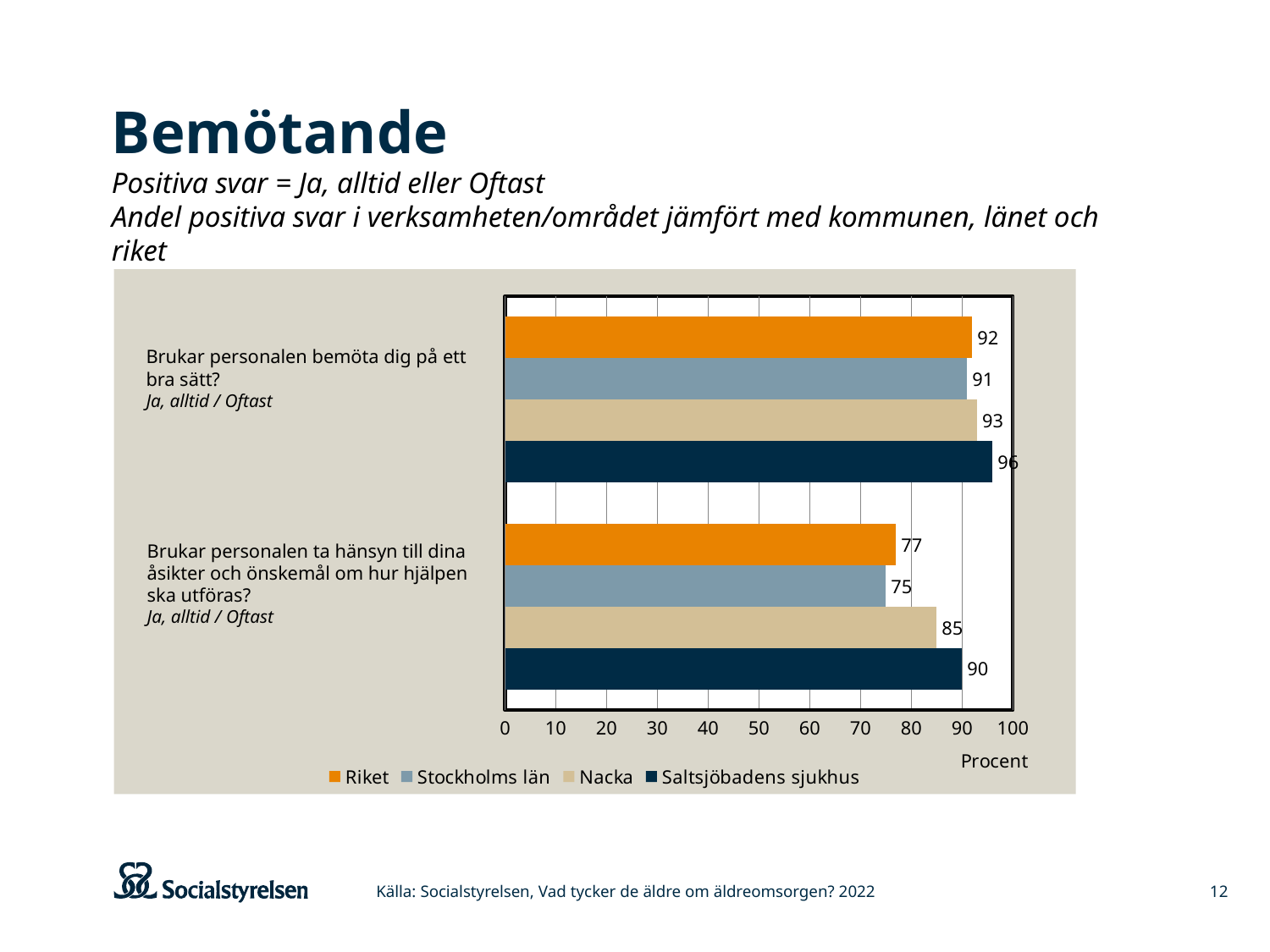
Which series has the lowest value for the question 'Brukar personalen ta hänsyn till dina åsikter och önskemål om hur hjälpen ska utföras?'? Stockholms län What is the value for Stockholms län for the question 'Brukar personalen bemöta dig på ett bra sätt?'? 91 How many question categories are shown on the chart? 2 How many series does the legend list? 4 Which is larger for Nacka: the value for 'Brukar personalen bemöta dig på ett bra sätt?' or for 'Brukar personalen ta hänsyn till dina åsikter och önskemål om hur hjälpen ska utföras?'? Brukar personalen bemöta dig på ett bra sätt? What is the difference between Saltsjöbadens sjukhus and Riket for the question 'Brukar personalen ta hänsyn till dina åsikter och önskemål om hur hjälpen ska utföras?'? 13 What is the value for Nacka for the question 'Brukar personalen ta hänsyn till dina åsikter och önskemål om hur hjälpen ska utföras?'? 85 Which series has the highest value for the question 'Brukar personalen bemöta dig på ett bra sätt?'? Saltsjöbadens sjukhus What type of chart is shown on the slide? bar chart What is the value for Riket for the question 'Brukar personalen ta hänsyn till dina åsikter och önskemål om hur hjälpen ska utföras?'? 77 What is the value for Saltsjöbadens sjukhus for the question 'Brukar personalen bemöta dig på ett bra sätt?'? 96 What unit is labelled on the x axis of the chart? Procent